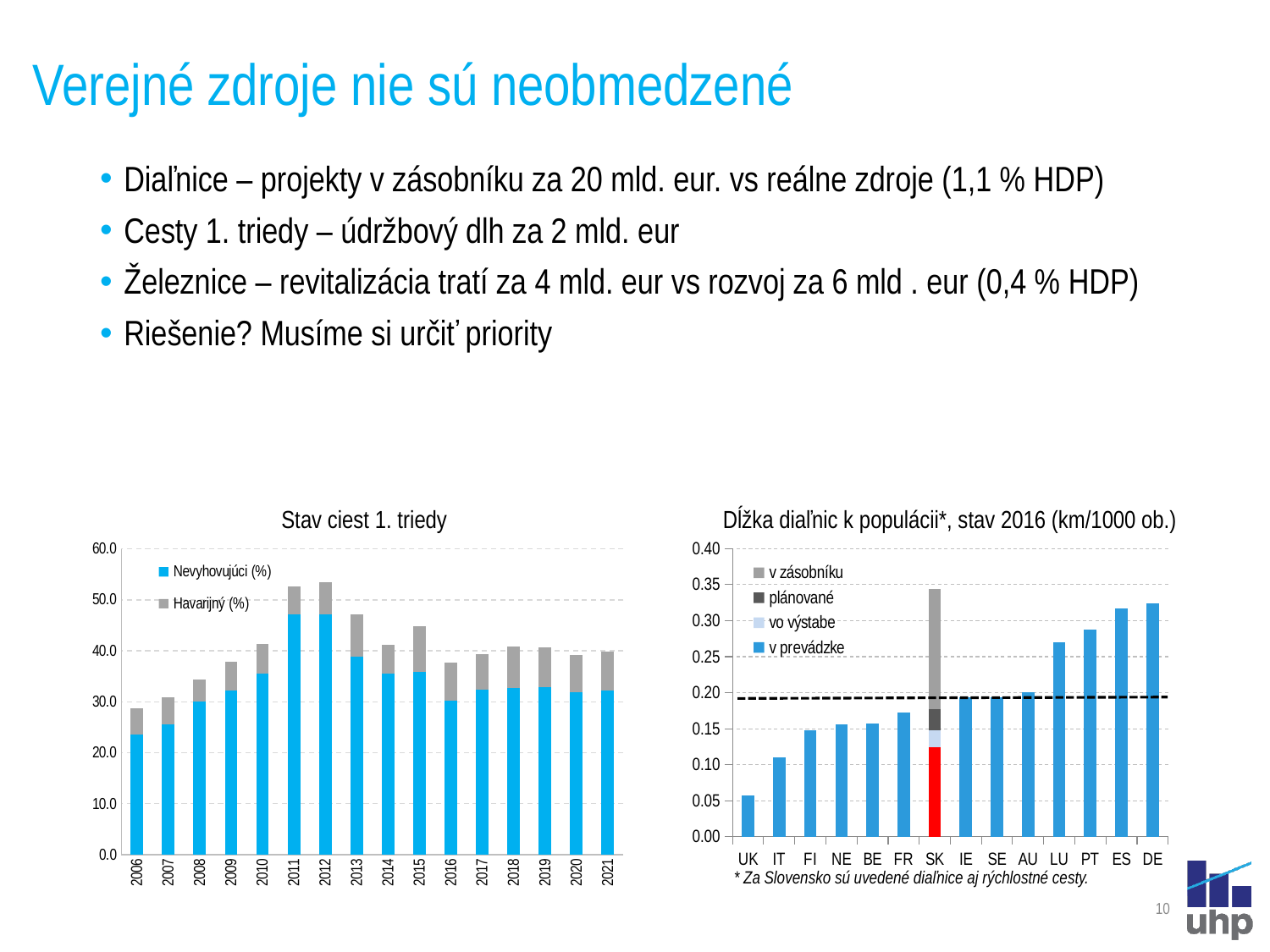
In "Dĺžka diaľnic k populácii*, stav 2016 (km/1000 ob.)", which country has the lowest bar? UK How many series does the legend of "Dĺžka diaľnic k populácii*, stav 2016 (km/1000 ob.)" list? 4 In "Stav ciest 1. triedy", do the total bars rise or fall from 2006 to 2011? rise In "Dĺžka diaľnic k populácii*, stav 2016 (km/1000 ob.)", is the value for DE greater or less than 0.30? greater In "Dĺžka diaľnic k populácii*, stav 2016 (km/1000 ob.)", which is larger, the bar for LU or the bar for IE? LU How many years are shown on the x axis of "Stav ciest 1. triedy"? 16 How many series does the legend of "Stav ciest 1. triedy" list? 2 What kind of chart is "Stav ciest 1. triedy"? bar chart In "Stav ciest 1. triedy", is the total bar for 2016 greater or less than 40.0? less In "Stav ciest 1. triedy", which year has the lowest total bar? 2006 How many countries are shown on the x axis of "Dĺžka diaľnic k populácii*, stav 2016 (km/1000 ob.)"? 14 In "Stav ciest 1. triedy", is the total bar for 2012 greater or less than 50.0? greater